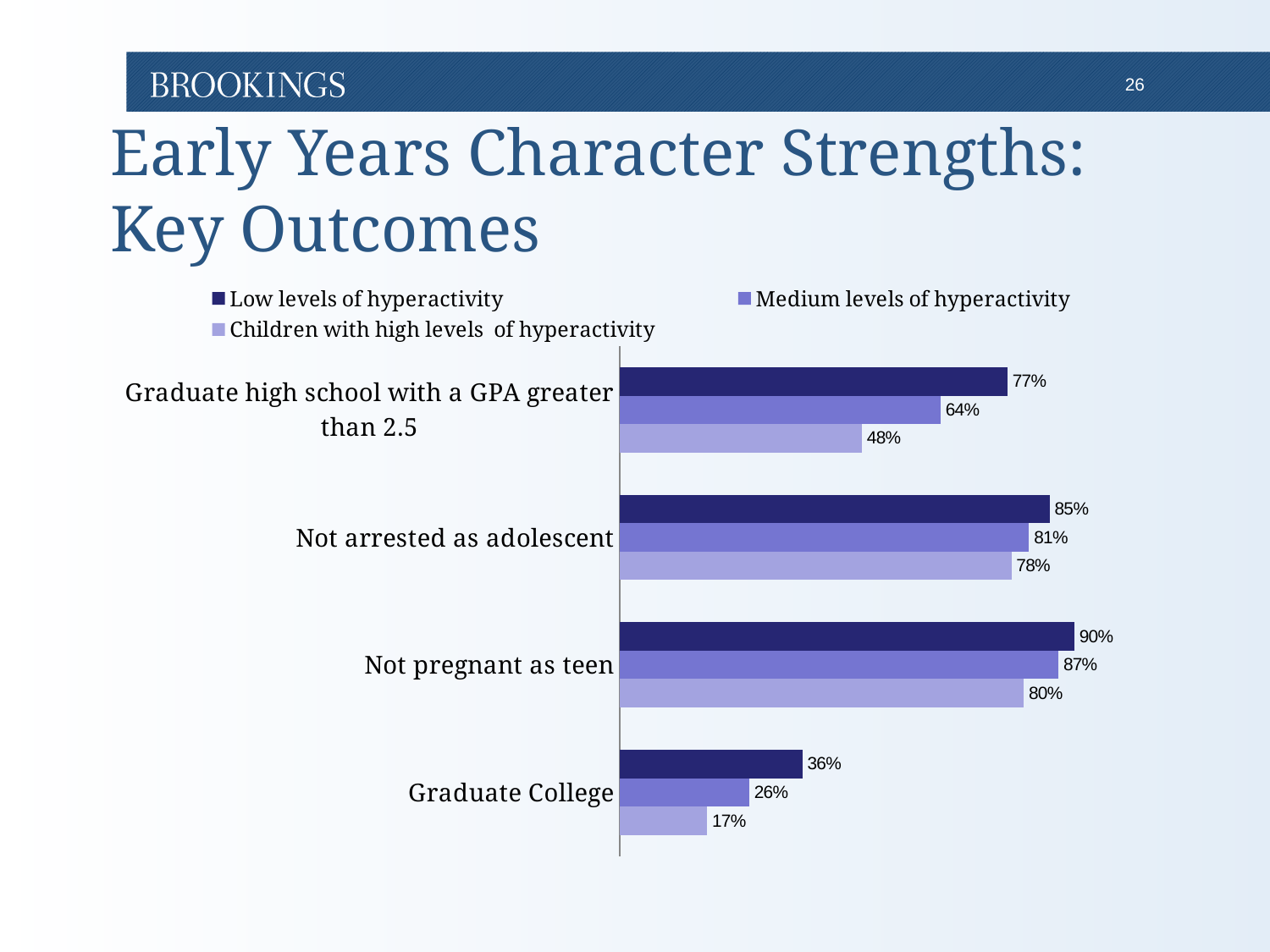
How many outcome categories are shown in the chart? 4 Which is larger for 'Not pregnant as teen': the value for low levels of hyperactivity or for high levels of hyperactivity? Low levels of hyperactivity What is the value for 'Medium levels of hyperactivity' in the 'Not arrested as adolescent' category? 81% What is the difference between the low and high hyperactivity values for 'Graduate high school with a GPA greater than 2.5'? 29 percentage points What is the value for 'Children with high levels of hyperactivity' in the 'Graduate College' category? 17% Which series is shown in the darkest colour in the chart? Low levels of hyperactivity Which category has the lowest value for the 'Medium levels of hyperactivity' series? Graduate College What is the difference between the 'Low levels of hyperactivity' and 'Medium levels of hyperactivity' values for 'Graduate College'? 10 percentage points How many series does the legend list? 3 Which category has the highest value for the 'Low levels of hyperactivity' series? Not pregnant as teen What kind of chart is shown on the slide? Bar chart What percentage of children with low levels of hyperactivity graduate high school with a GPA greater than 2.5? 77%